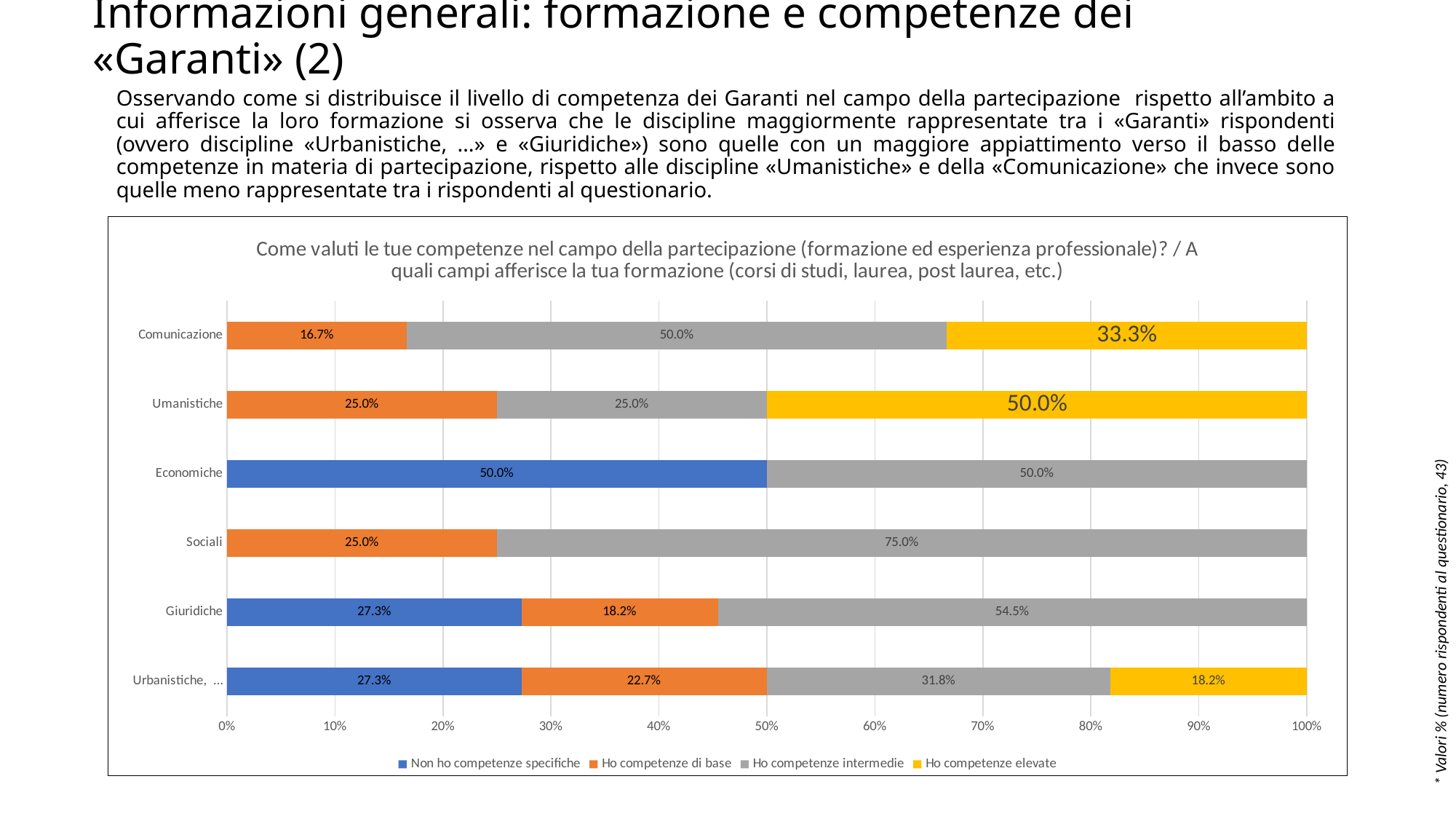
What is the value of 'Ho competenze di base' for Urbanistiche, ...? 22.7% How many series does the chart legend list? 4 Which colour represents 'Ho competenze elevate' in the chart? Yellow Which category has the lowest value for 'Ho competenze elevate' among those where it is shown? Urbanistiche, ... Which category has the highest value for 'Ho competenze intermedie'? Sociali How many categories (discipline groups) are shown on the y axis of the chart? 6 What is the value of 'Ho competenze elevate' for Comunicazione? 33.3% What type of chart is shown on the slide? Stacked bar chart What is the value of 'Non ho competenze specifiche' for Giuridiche? 27.3% What is the value of 'Ho competenze intermedie' for Sociali? 75.0% Which is larger: 'Ho competenze di base' for Umanistiche or for Comunicazione? Umanistiche What is the difference between the 'Ho competenze elevate' values for Umanistiche and Comunicazione? 16.7%